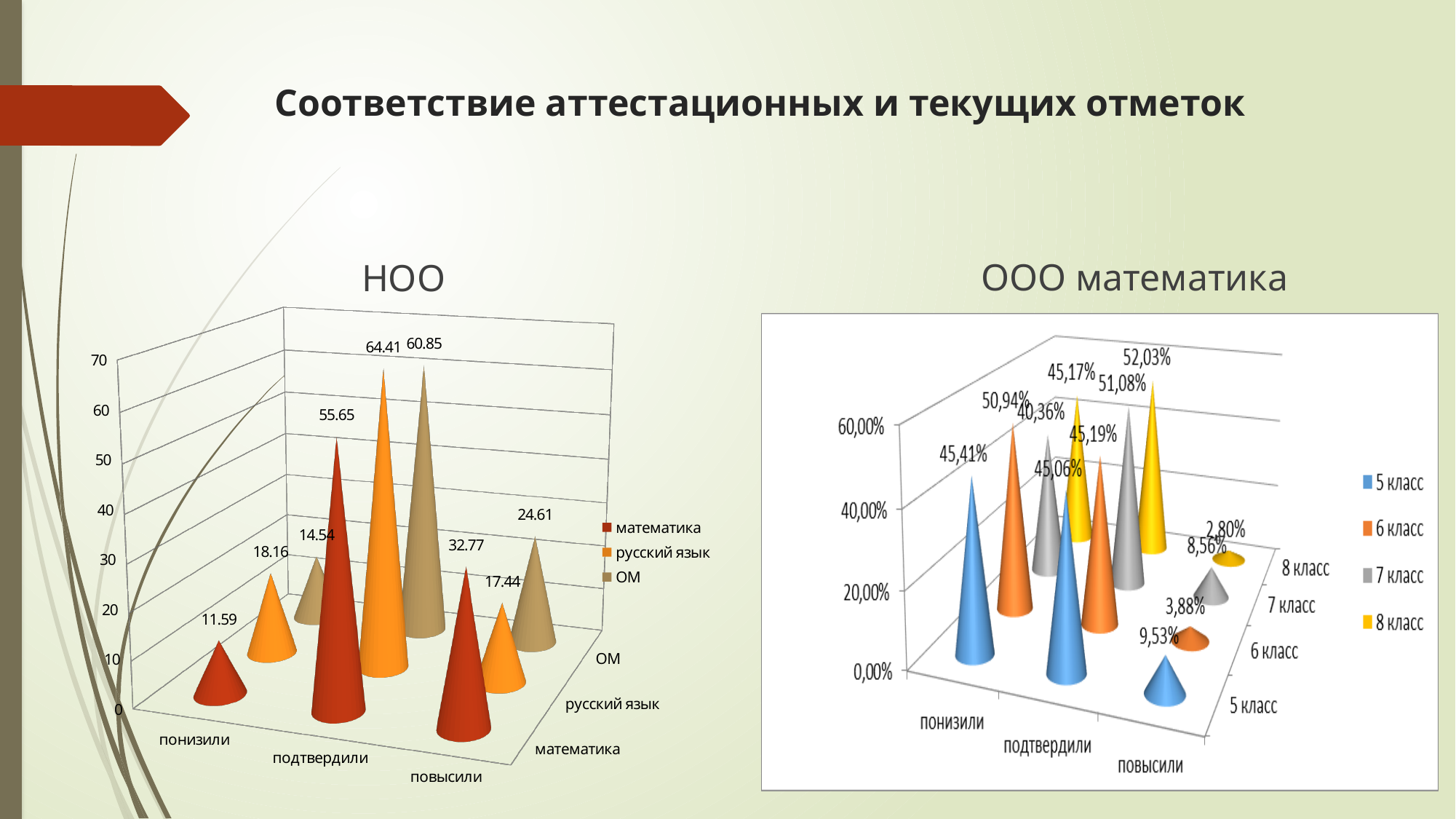
In the НОО chart, what is the value for русский язык in the подтвердили category? 64.41 In the ООО математика chart, what is the value for 6 класс in the понизили category? 50,94% In the НОО chart, which is larger in the повысили category: математика or русский язык? математика In the НОО chart, which series has the highest value in the подтвердили category? русский язык In the НОО chart, which series has the lowest value in the понизили category? математика In the НОО chart, what is the difference between the русский язык and математика values in the понизили category? 6.57 How many series does the legend of the НОО chart list? 3 In the ООО математика chart, what is the value for 5 класс in the повысили category? 9,53% In the ООО математика chart, what is the value for 8 класс in the повысили category? 2,80% In the НОО chart, what is the value for ОМ in the повысили category? 24.61 How many series does the legend of the ООО математика chart list? 4 In the НОО chart, what is the value for математика in the подтвердили category? 55.65